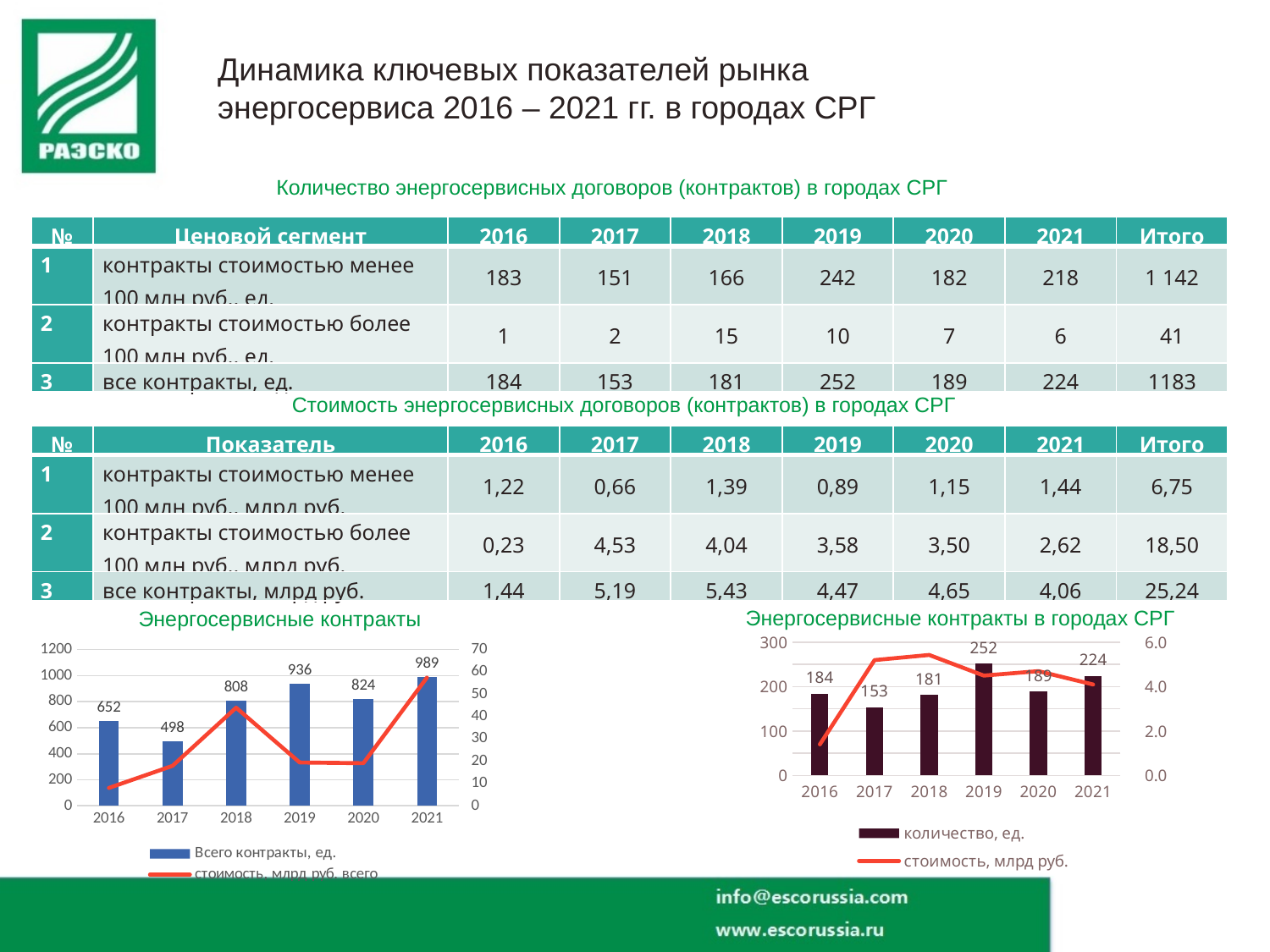
What kind of chart is the one titled "Энергосервисные контракты в городах СРГ"? Combined bar and line chart In the chart titled "Энергосервисные контракты в городах СРГ", how many years are shown on the x axis? 6 In the chart titled "Энергосервисные контракты в городах СРГ", what is the difference between the bar values for 2021 and 2017? 71 In the chart titled "Энергосервисные контракты в городах СРГ", which year has the highest bar? 2019 In the chart titled "Энергосервисные контракты в городах СРГ", what is the label of the line series in the legend? стоимость, млрд руб. In the chart titled "Энергосервисные контракты в городах СРГ", what is the value of the bar for 2019? 252 In the chart titled "Энергосервисные контракты", how many series does the legend list? 2 In the chart titled "Энергосервисные контракты", which bar is larger, 2016 or 2020? 2020 In the chart titled "Энергосервисные контракты в городах СРГ", is the line value for 2016 greater or less than 2.0 on the right axis? less In the chart titled "Энергосервисные контракты", what is the value of the bar for 2021? 989 In the chart titled "Энергосервисные контракты", which year has the lowest bar? 2017 In the chart titled "Энергосервисные контракты", what is the difference between the bar values for 2019 and 2018? 128